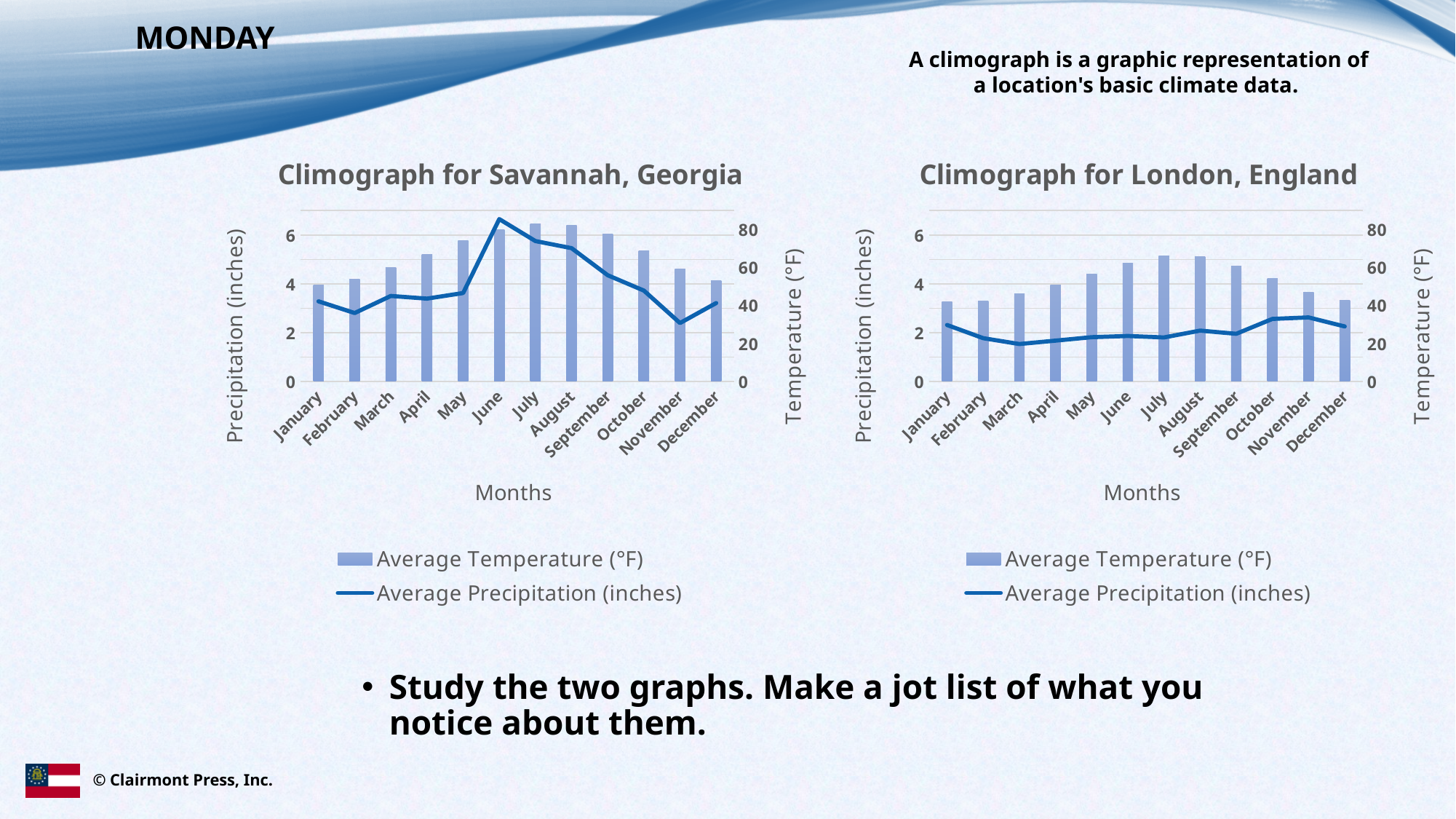
Which chart shows the higher average precipitation in June, the Climograph for Savannah, Georgia or the Climograph for London, England? Climograph for Savannah, Georgia In the Climograph for London, England, which series is drawn as a line? Average Precipitation (inches) In the Climograph for London, England, is the average temperature for January greater or less than 60? less How many series does the legend of the Climograph for Savannah, Georgia list? 2 In the Climograph for Savannah, Georgia, which month has the highest average precipitation? June What kind of chart is the Climograph for Savannah, Georgia? A combination bar and line chart In the Climograph for Savannah, Georgia, is the average temperature for July greater or less than 60? greater In the Climograph for Savannah, Georgia, does the average precipitation rise or fall from June to November? fall In the Climograph for London, England, is the average precipitation for March greater or less than 2? less How many months are plotted on the x axis of the Climograph for London, England? 12 In the Climograph for Savannah, Georgia, which month has the lowest average precipitation? November